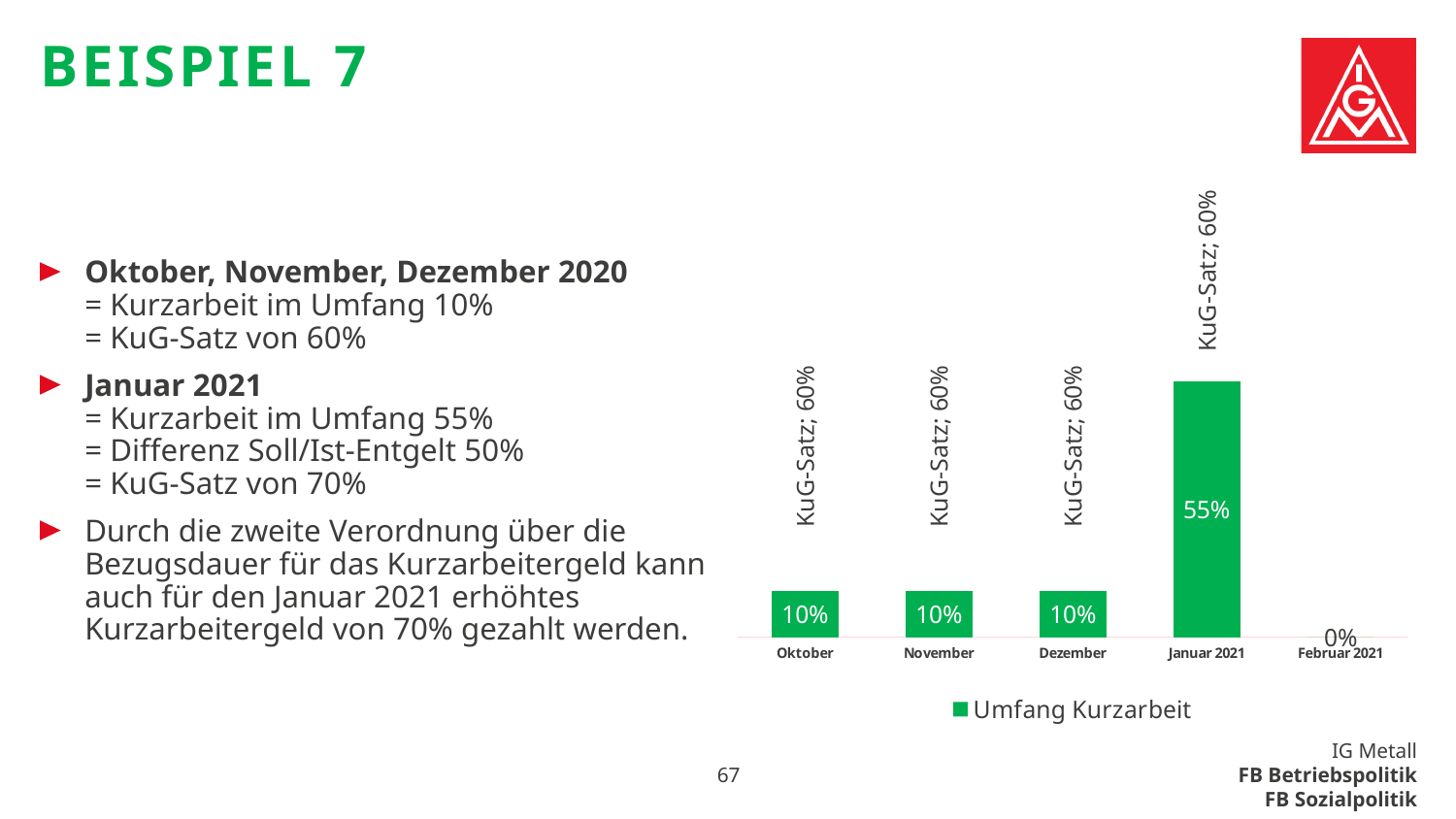
What is the value for Januar 2021 in the chart? 55% How many categories are shown on the x axis of the chart? 5 What is the name of the series in the chart legend? Umfang Kurzarbeit What is the value for Oktober in the chart? 10% What is the value for Februar 2021 in the chart? 0% What is the difference between the values for Januar 2021 and Dezember? 45% What kind of chart is shown on the slide? bar chart Which category has the lowest value in the chart? Februar 2021 Which is larger, the value for November or the value for Januar 2021? Januar 2021 What KuG-Satz label is printed above the Oktober bar? KuG-Satz; 60% Which category has the highest value in the chart? Januar 2021 How many series does the chart legend list? 1